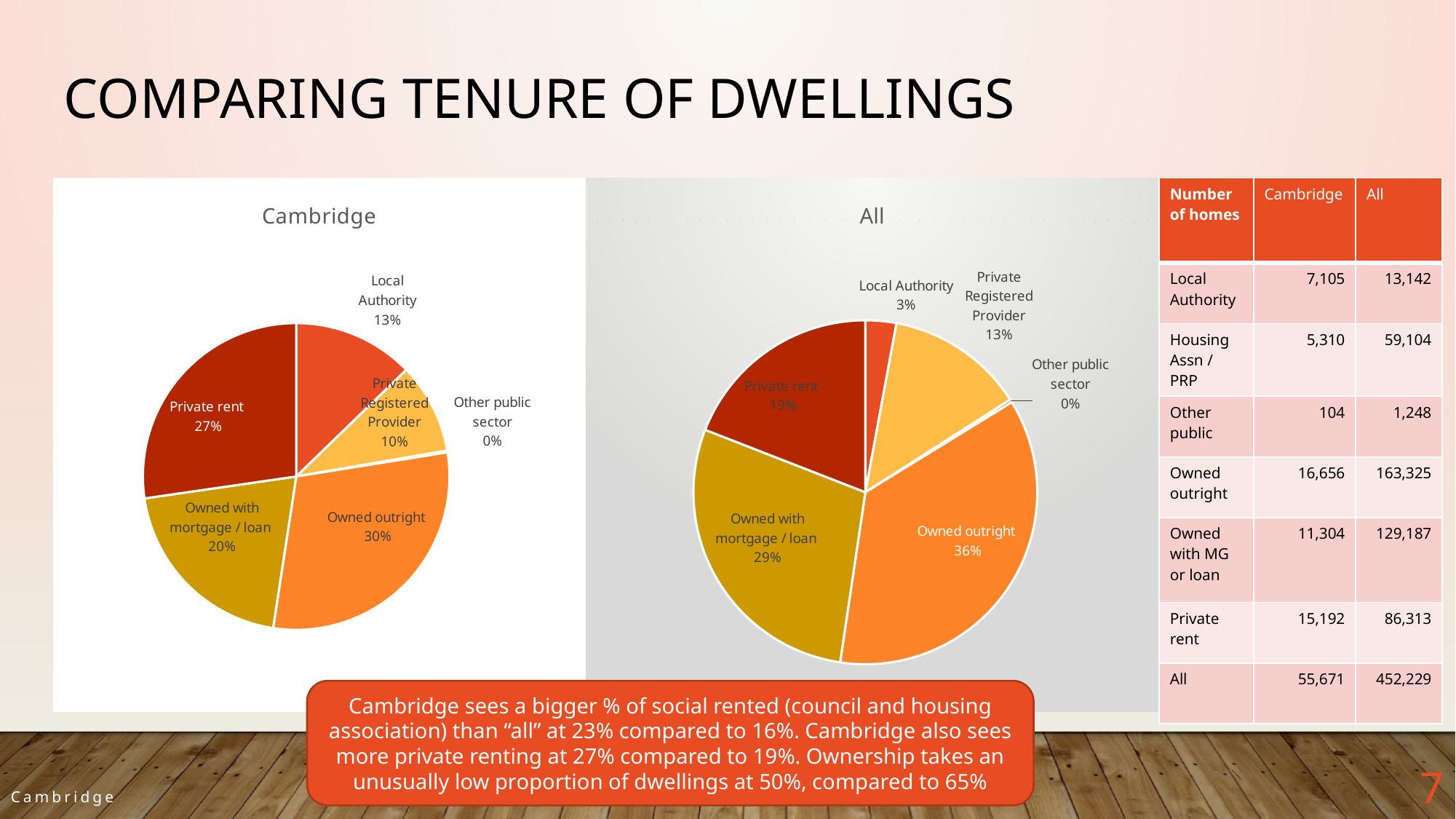
What is the title of the pie chart on the left? Cambridge In the Cambridge pie chart, what share is Private rent? 27% What type of chart is the All chart? Pie chart In the Cambridge pie chart, which is larger: Private rent or Owned with mortgage / loan? Private rent In the All pie chart, what share is Local Authority? 3% In the Cambridge pie chart, what share is Private Registered Provider? 10% In the All pie chart, what is the difference between Owned outright and Owned with mortgage / loan? 7% In the Cambridge pie chart, which category has the largest share? Owned outright In the Cambridge pie chart, what is the combined share of Local Authority and Private Registered Provider? 23% How many categories does the Cambridge pie chart show? 6 In the All pie chart, which category has the smallest share? Other public sector In the All pie chart, what share is Owned outright? 36%